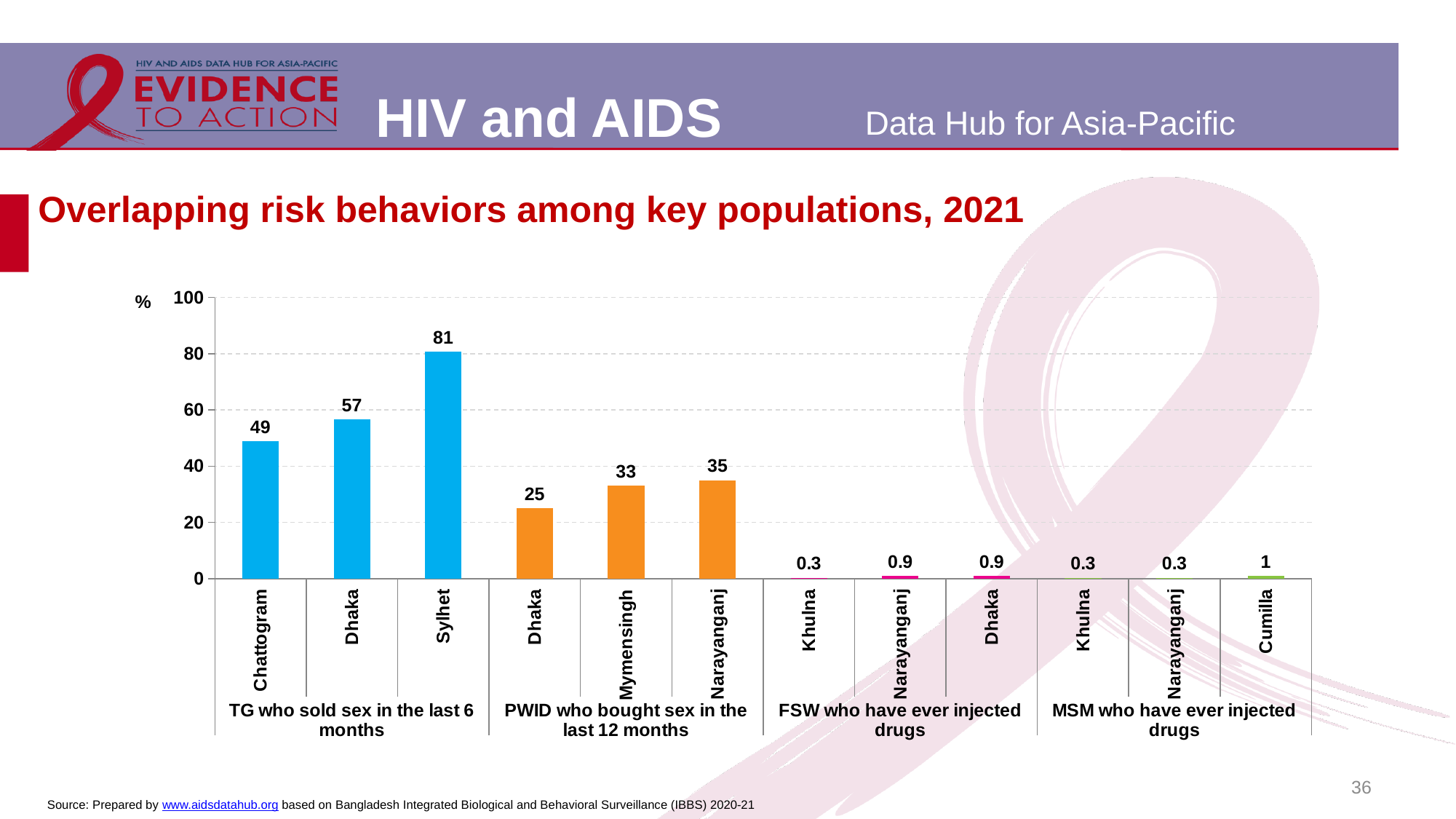
What is the value for Sylhet in the 'TG who sold sex in the last 6 months' group? 81 What is the difference between the values for Sylhet and Chattogram in the 'TG who sold sex in the last 6 months' group? 32 What kind of chart is shown on the slide? Bar chart What is the value for Mymensingh in the 'PWID who bought sex in the last 12 months' group? 33 How many bars are plotted in the chart? 12 What is the title of the chart? Overlapping risk behaviors among key populations, 2021 What is the value for Cumilla in the 'MSM who have ever injected drugs' group? 1 What is the value for Khulna in the 'FSW who have ever injected drugs' group? 0.3 Which city has the lowest value in the 'PWID who bought sex in the last 12 months' group? Dhaka Is the value for Dhaka in the 'TG who sold sex in the last 6 months' group greater or less than 40? greater Which is larger: the value for Narayanganj among PWID or the value for Dhaka among TG? Dhaka among TG Which city has the highest value in the chart? Sylhet